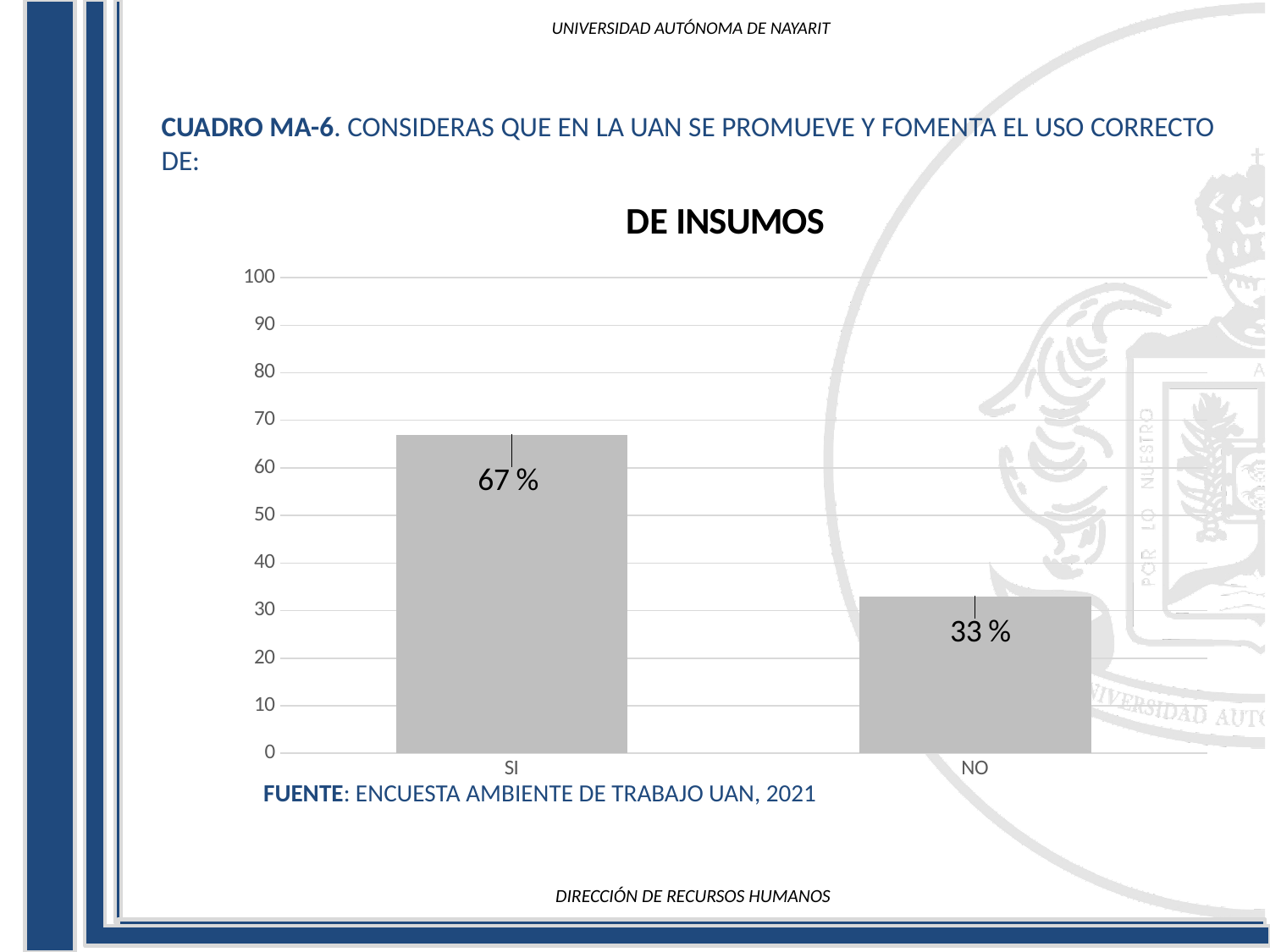
Which category has the lowest value? NO What is the maximum value shown on the y axis? 100 What is the value for NO? 33 % Is the value for NO greater or less than 40? less Which category has the highest value? SI What is the difference between the values for SI and NO? 34 % What is the title of the chart? DE INSUMOS How many categories are shown on the x axis? 2 What kind of chart is shown on the slide? bar chart What is the value for SI? 67 % Which is larger, the value for SI or the value for NO? SI Is the value for SI greater or less than 60? greater